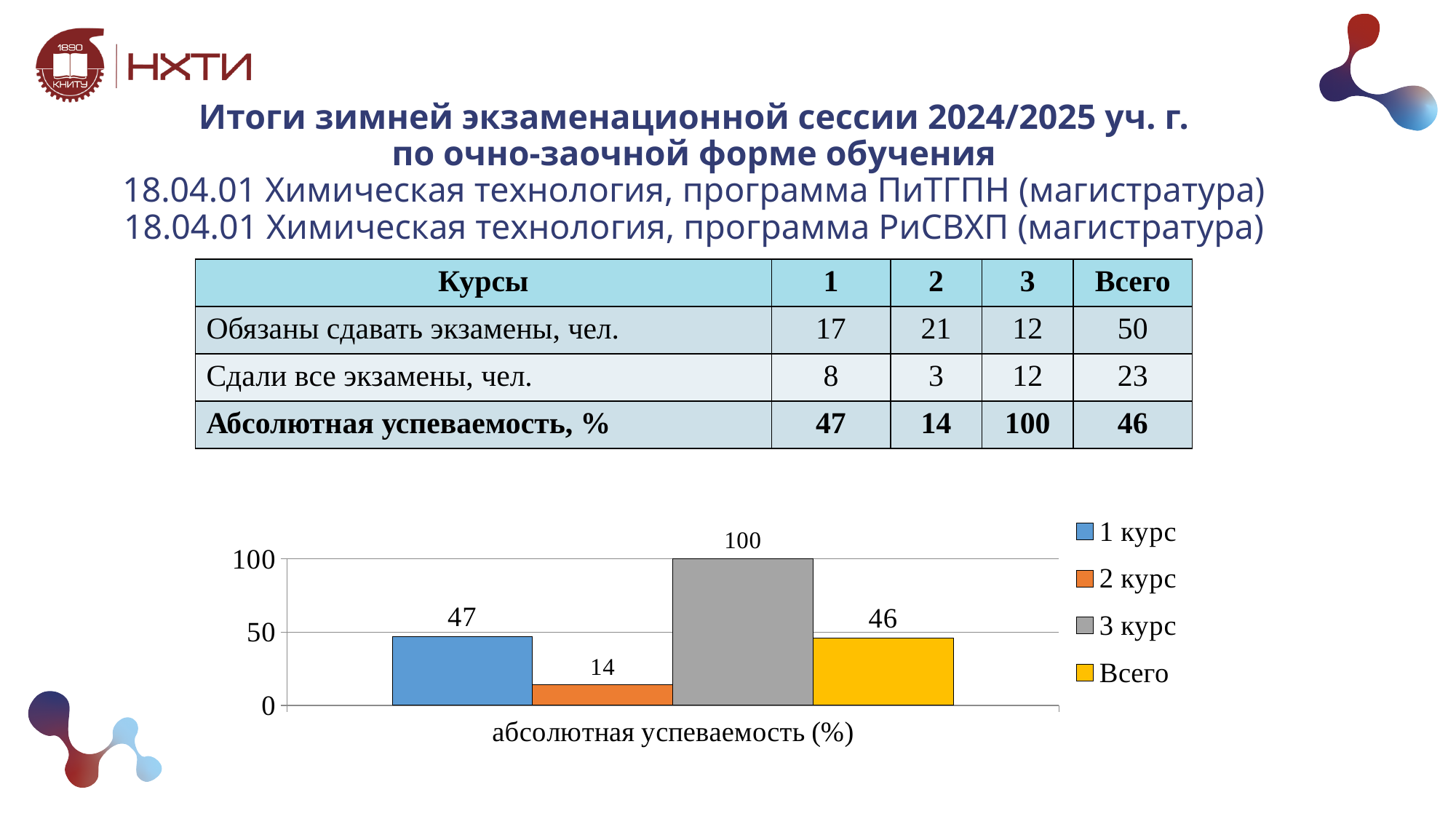
Which series has the lowest value in the chart? 2 курс What is the value for Всего in the chart? 46 How many series does the legend list? 4 What is the value for 3 курс in the chart? 100 What is the value for 1 курс in the chart? 47 What is the difference between the values for 3 курс and 2 курс? 86 What kind of chart is shown on the slide? bar chart What is the value for 2 курс in the chart? 14 Which series has the highest value in the chart? 3 курс What is the label on the x axis of the chart? абсолютная успеваемость (%) Is the value for 2 курс greater or less than 50? less Which is larger, the value for 1 курс or the value for Всего? 1 курс